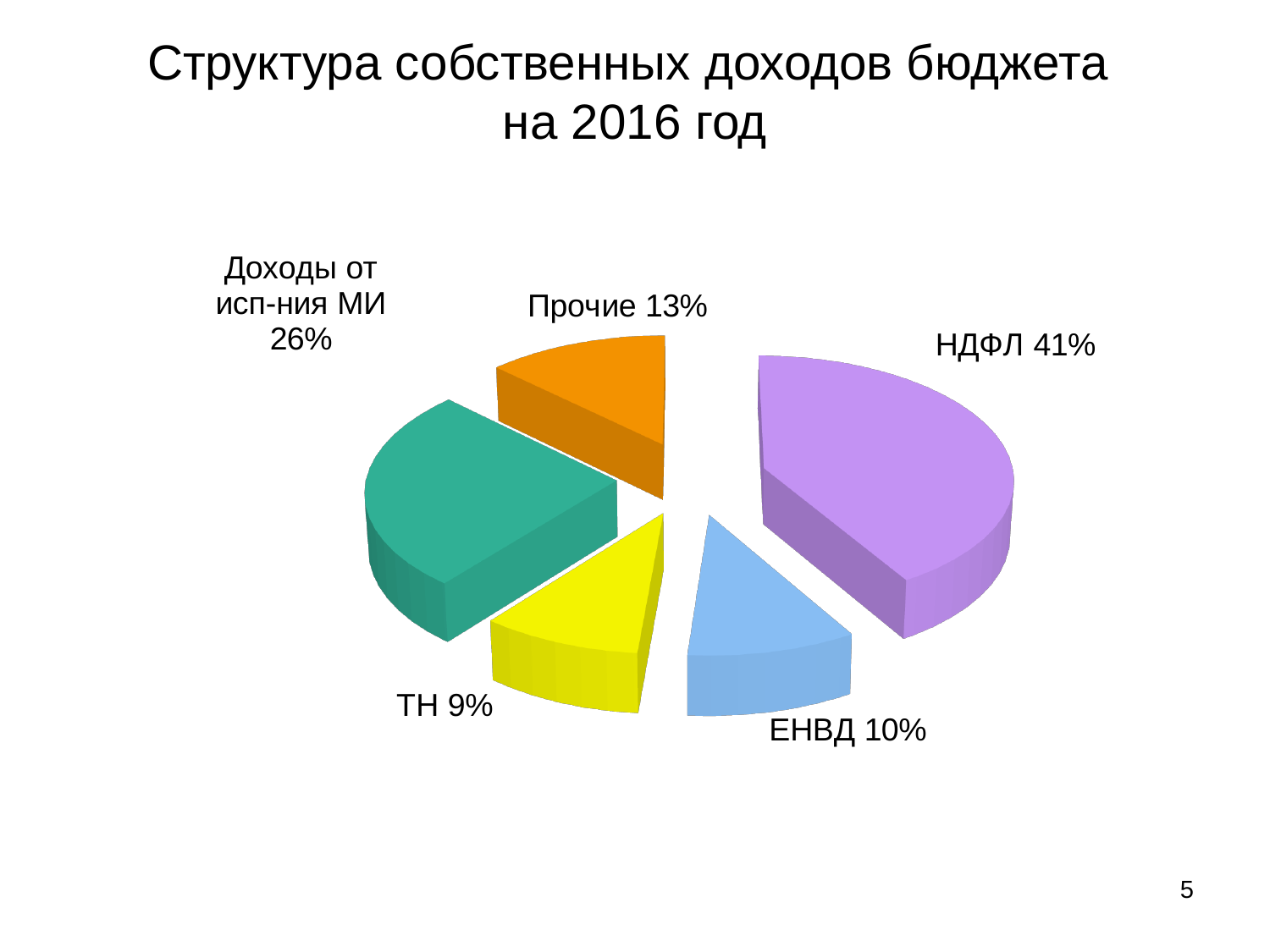
Which is larger, the share for Прочие or the share for ЕНВД? Прочие What kind of chart is shown on the slide? pie chart What share of the pie does Доходы от исп-ния МИ have? 26% What share of the pie does ЕНВД have? 10% What share of the pie does ТН have? 9% Which category has the smallest slice of the pie? ТН How many slices does the pie chart have? 5 What is the difference in percentage points between НДФЛ and Доходы от исп-ния МИ? 15 What share of the pie does НДФЛ have? 41% What is the title of the chart? Структура собственных доходов бюджета на 2016 год Which category has the largest slice of the pie? НДФЛ What share of the pie does Прочие have? 13%